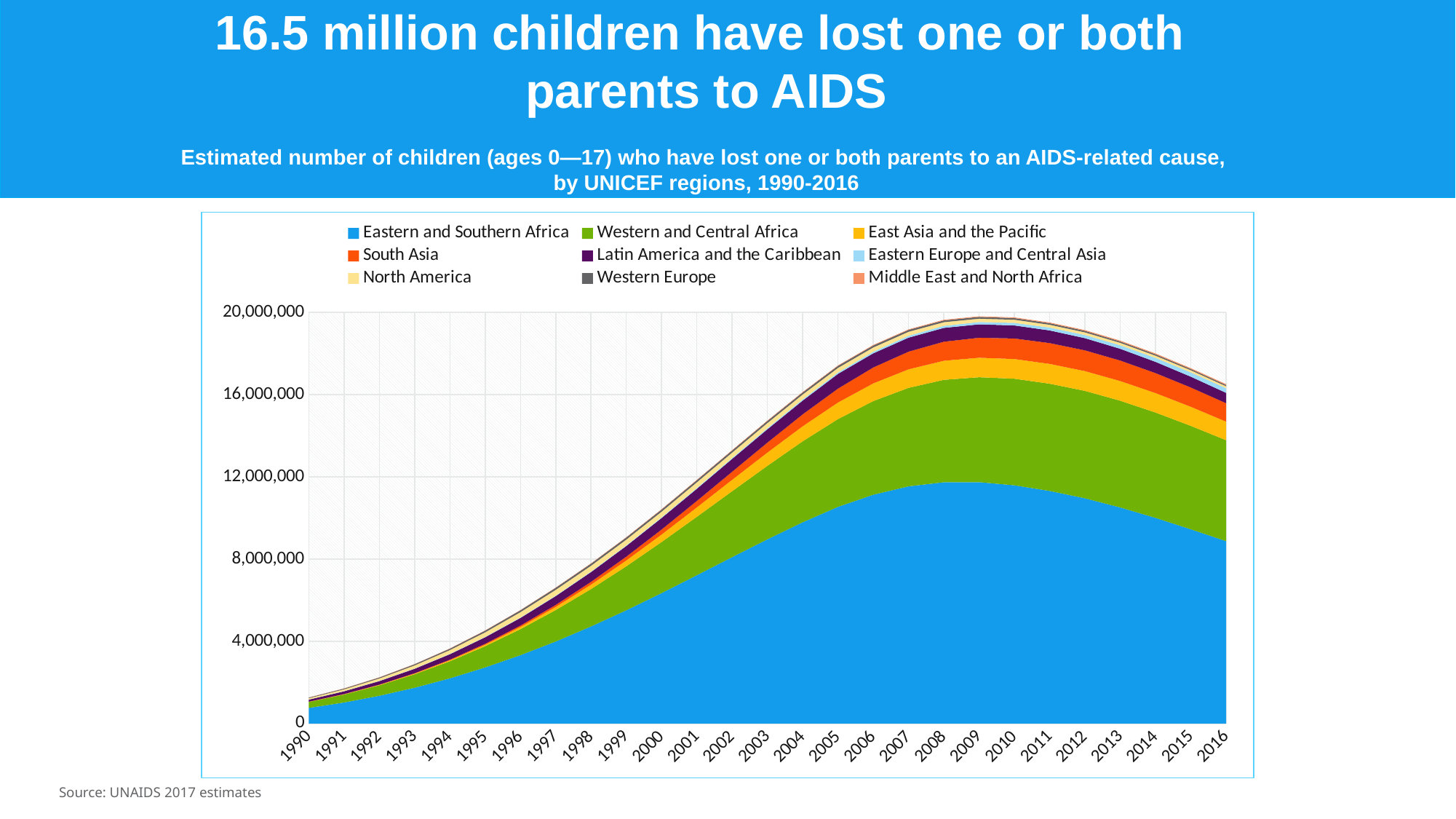
What kind of chart is shown on the slide? Stacked area chart How many years are shown along the x axis? 27 In 2016, which is larger: the value for Eastern and Southern Africa or the value for Western and Central Africa? Eastern and Southern Africa Which region accounts for the largest share of the stacked total across the chart? Eastern and Southern Africa Is the total number of children in 1990 greater or less than 4,000,000? less Does the total number of children rise or fall between 1990 and 2008? rise Does the total number of children rise or fall between 2010 and 2016? fall How many series does the legend list? 9 Is the total number of children in 2009 greater or less than 16,000,000? greater Is the total number of children in 2000 greater or less than 8,000,000? greater What colour represents Eastern and Southern Africa in the chart? Blue